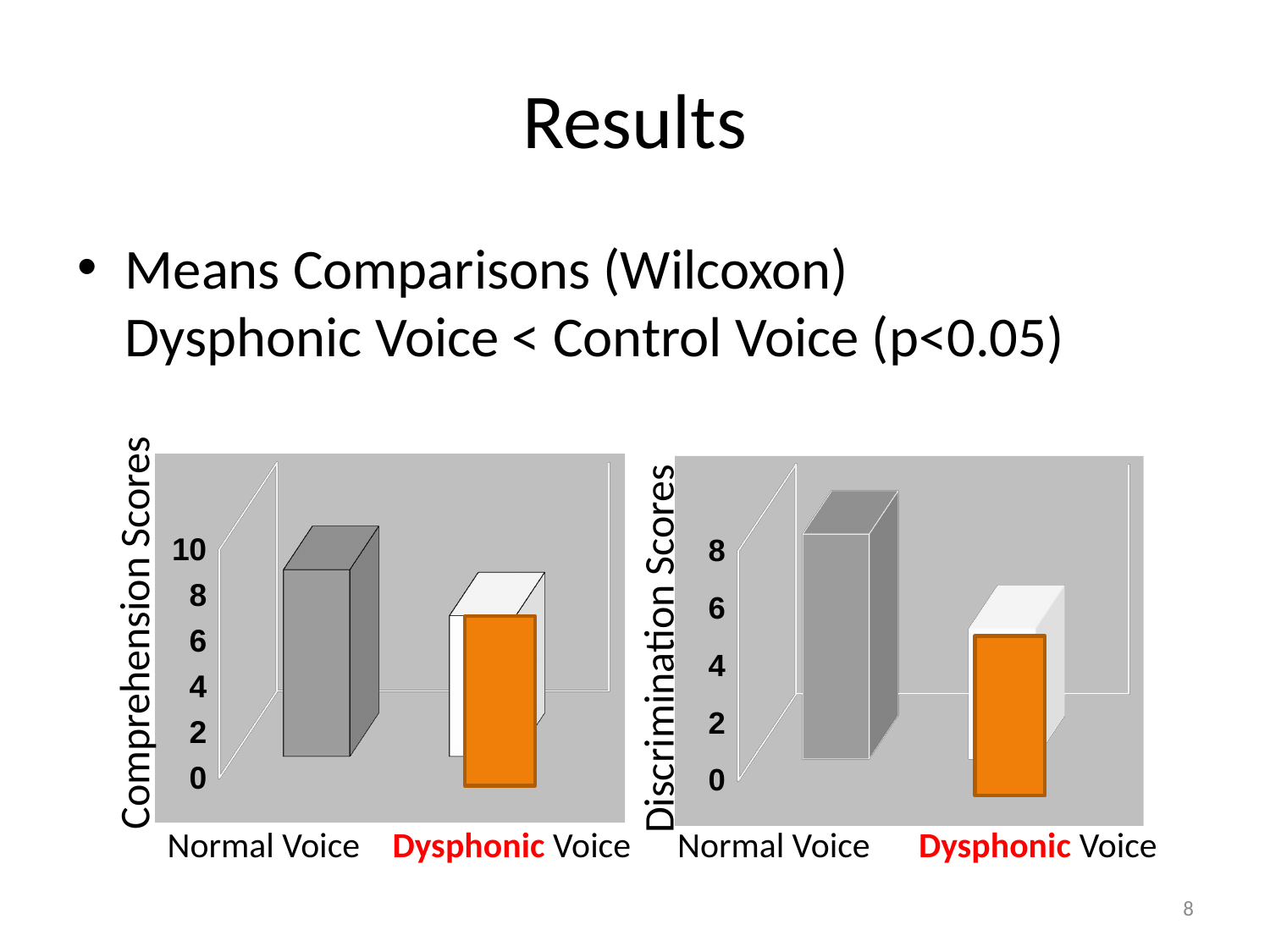
In the Discrimination Scores chart, is the value for Dysphonic Voice greater or less than 2? greater What kind of chart is the Comprehension Scores chart on the left? bar chart In the Comprehension Scores chart, which category has the highest bar? Normal Voice How many categories are shown on the x axis of the Discrimination Scores chart? 2 In the Comprehension Scores chart, is the value for Dysphonic Voice greater or less than 4? greater In the Discrimination Scores chart, is the value for Normal Voice greater or less than 6? greater What is the y-axis label of the chart on the right? Discrimination Scores In the Discrimination Scores chart, do the values rise or fall going from Normal Voice to Dysphonic Voice? fall In the Comprehension Scores chart, what colour is the Dysphonic Voice bar? orange In the Discrimination Scores chart, which category has the lowest bar? Dysphonic Voice In the Comprehension Scores chart, which category has the higher bar, Normal Voice or Dysphonic Voice? Normal Voice